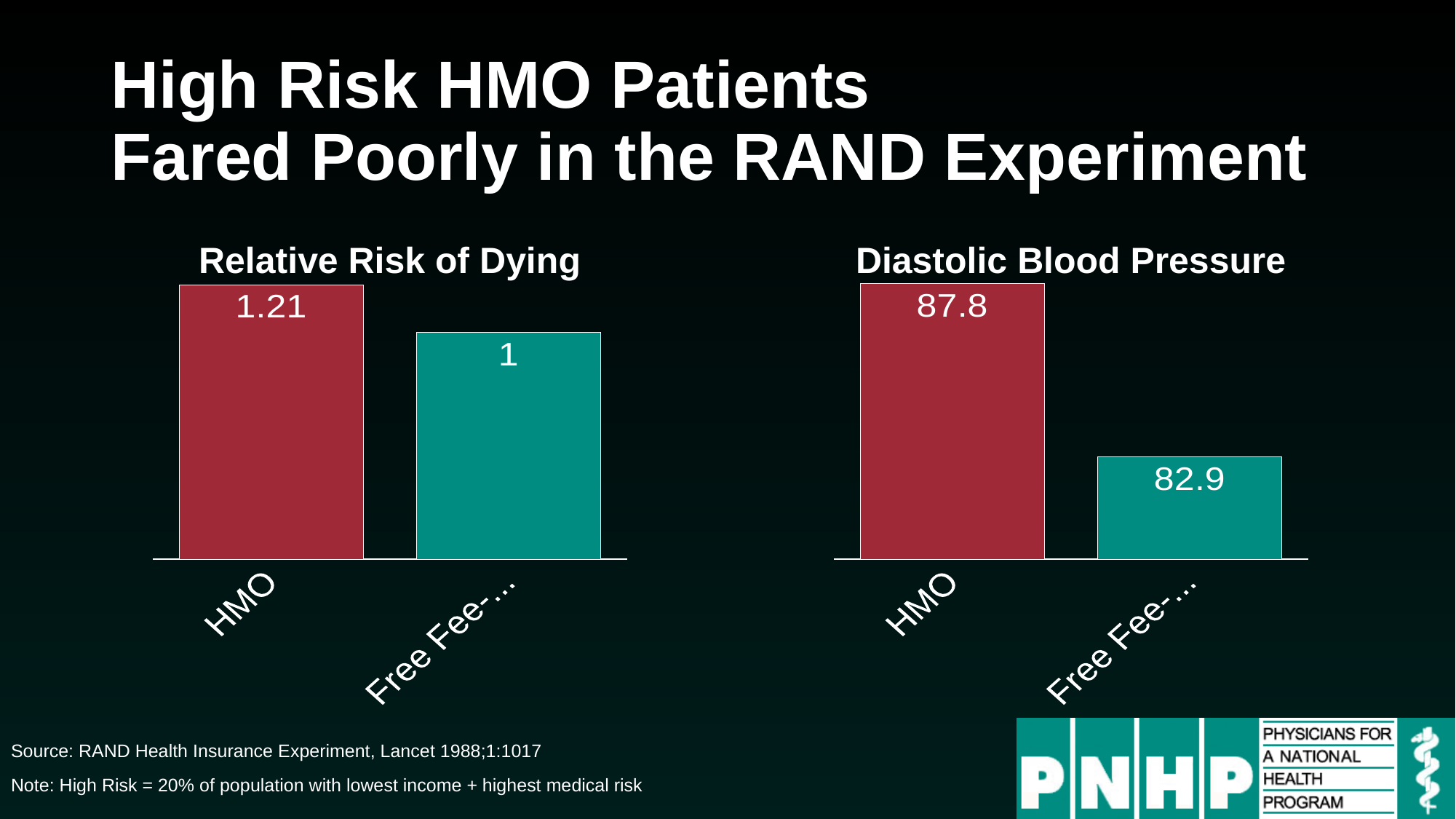
In the 'Diastolic Blood Pressure' chart, which category has the lowest value? Free Fee-… In the 'Relative Risk of Dying' chart, what is the value for the second bar (labelled 'Free Fee-…')? 1 What kind of chart is the 'Diastolic Blood Pressure' chart? Bar chart In the 'Diastolic Blood Pressure' chart, what is the difference between the HMO value and the 'Free Fee-…' value? 4.9 How many bars are in the 'Relative Risk of Dying' chart? 2 In the 'Diastolic Blood Pressure' chart, what is the value for the second bar (labelled 'Free Fee-…')? 82.9 In the 'Diastolic Blood Pressure' chart, which is larger: the HMO value or the 'Free Fee-…' value? HMO In the 'Diastolic Blood Pressure' chart, what is the value for HMO? 87.8 In the 'Relative Risk of Dying' chart, what is the difference between the HMO value and the 'Free Fee-…' value? 0.21 In the 'Relative Risk of Dying' chart, which category has the highest value? HMO In the 'Relative Risk of Dying' chart, what is the value for HMO? 1.21 What colour is the HMO bar in the 'Relative Risk of Dying' chart? Red